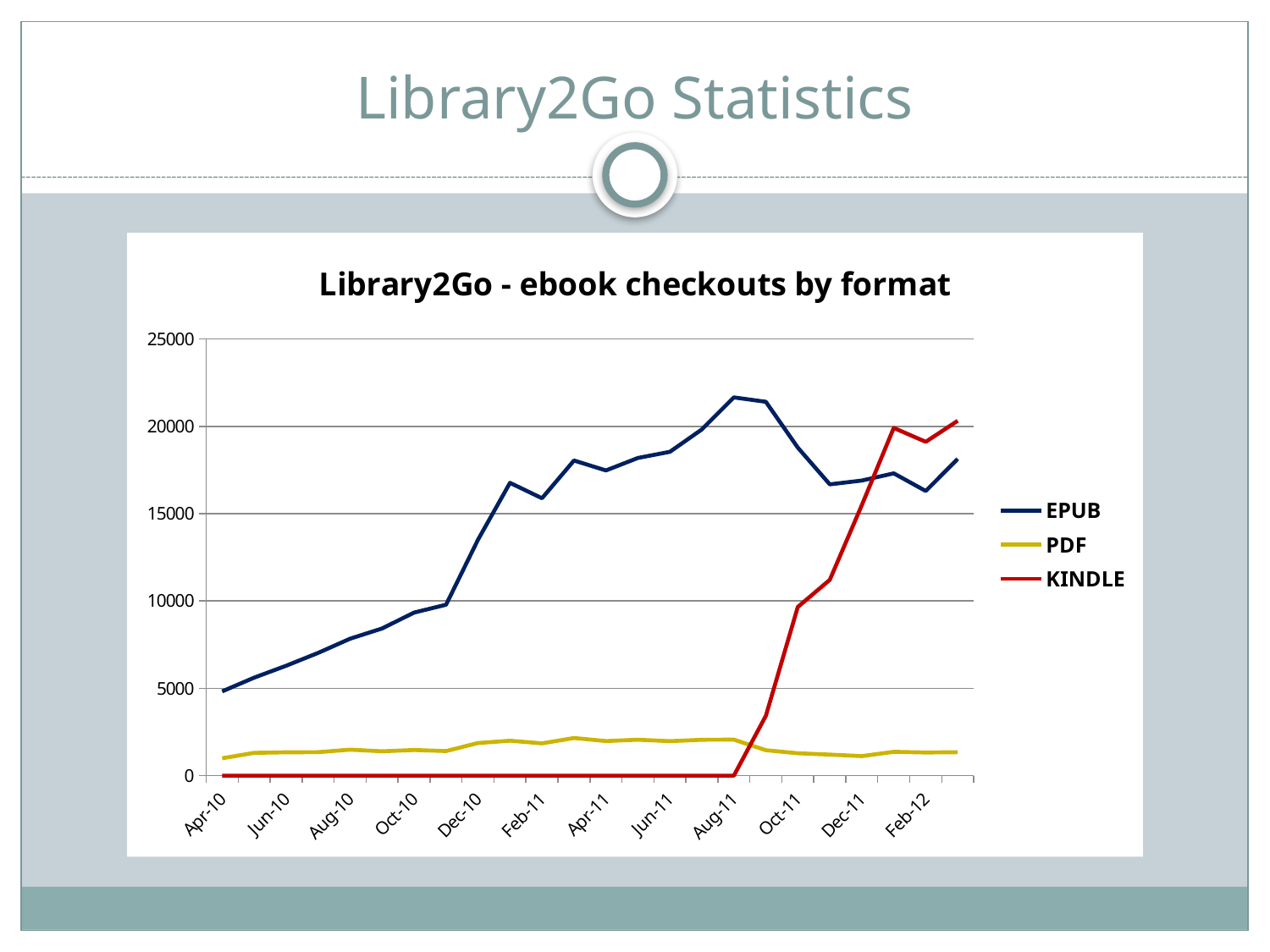
At Feb-12, which series has the larger value, EPUB or KINDLE? KINDLE Is the PDF value at Jun-10 greater or less than 5000? less At Oct-11, which series has the larger value, EPUB or KINDLE? EPUB Is the EPUB value at Feb-11 greater or less than 15000? greater Is the KINDLE value at Feb-12 greater or less than 15000? greater What kind of chart is shown on the slide? line chart Does the EPUB line rise or fall from Apr-10 to Dec-10? rise What is the title of the chart? Library2Go - ebook checkouts by format Which series is drawn in red? KINDLE Which series has the highest value at Apr-11? EPUB How many series does the legend list? 3